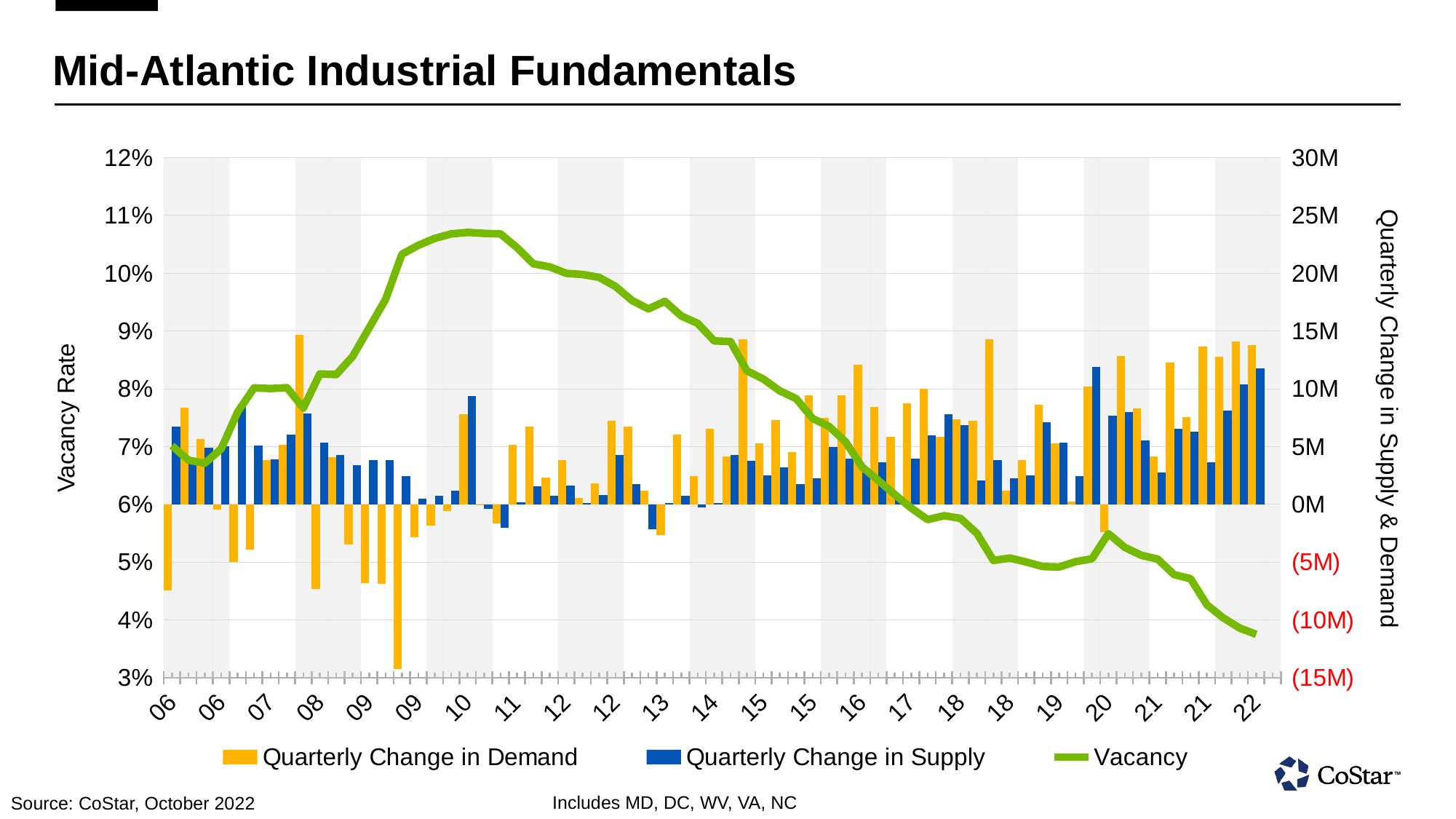
Is the Vacancy rate in 2010 greater or less than 10%? greater Around which year does the Vacancy line reach its highest point? 2010 Does the Vacancy line rise or fall between 2010 and 2022? Fall What is the label of the left vertical axis? Vacancy Rate Is the Vacancy rate at the end of 2022 greater or less than 5%? less What kind of chart is shown on the slide? Combined bar and line chart At which end of the x axis is the Vacancy line at its lowest, 06 or 22? 22 Which series is plotted as a line rather than bars? Vacancy Does the Vacancy line rise or fall between 06 and 2010? Rise How many series does the legend list? 3 Is the Vacancy rate higher in 2010 or in 2022? 2010 Is the tallest Quarterly Change in Demand bar (around 08) greater or less than 10M? greater